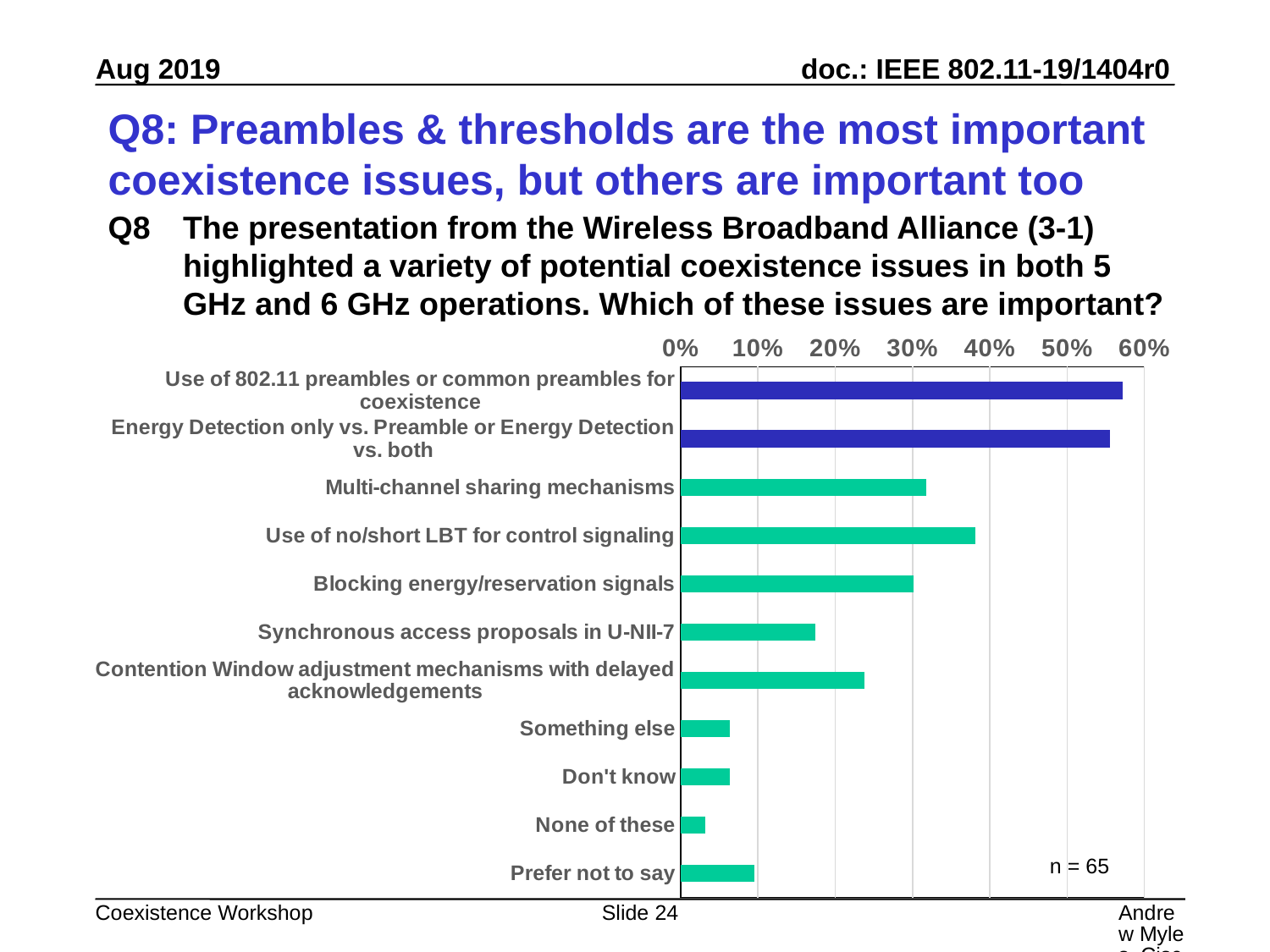
What sample size (n) is noted on the chart? n = 65 Is the value for 'Multi-channel sharing mechanisms' greater or less than 40%? less Is the value for 'Use of 802.11 preambles or common preambles for coexistence' greater or less than 50%? greater Is the value for 'Use of no/short LBT for control signaling' greater or less than 30%? greater How many categories (issues) are plotted in the chart? 11 Which category has the lowest value in the chart? None of these What kind of chart is shown on the slide? bar chart Which has the larger value: 'Use of no/short LBT for control signaling' or 'Multi-channel sharing mechanisms'? Use of no/short LBT for control signaling